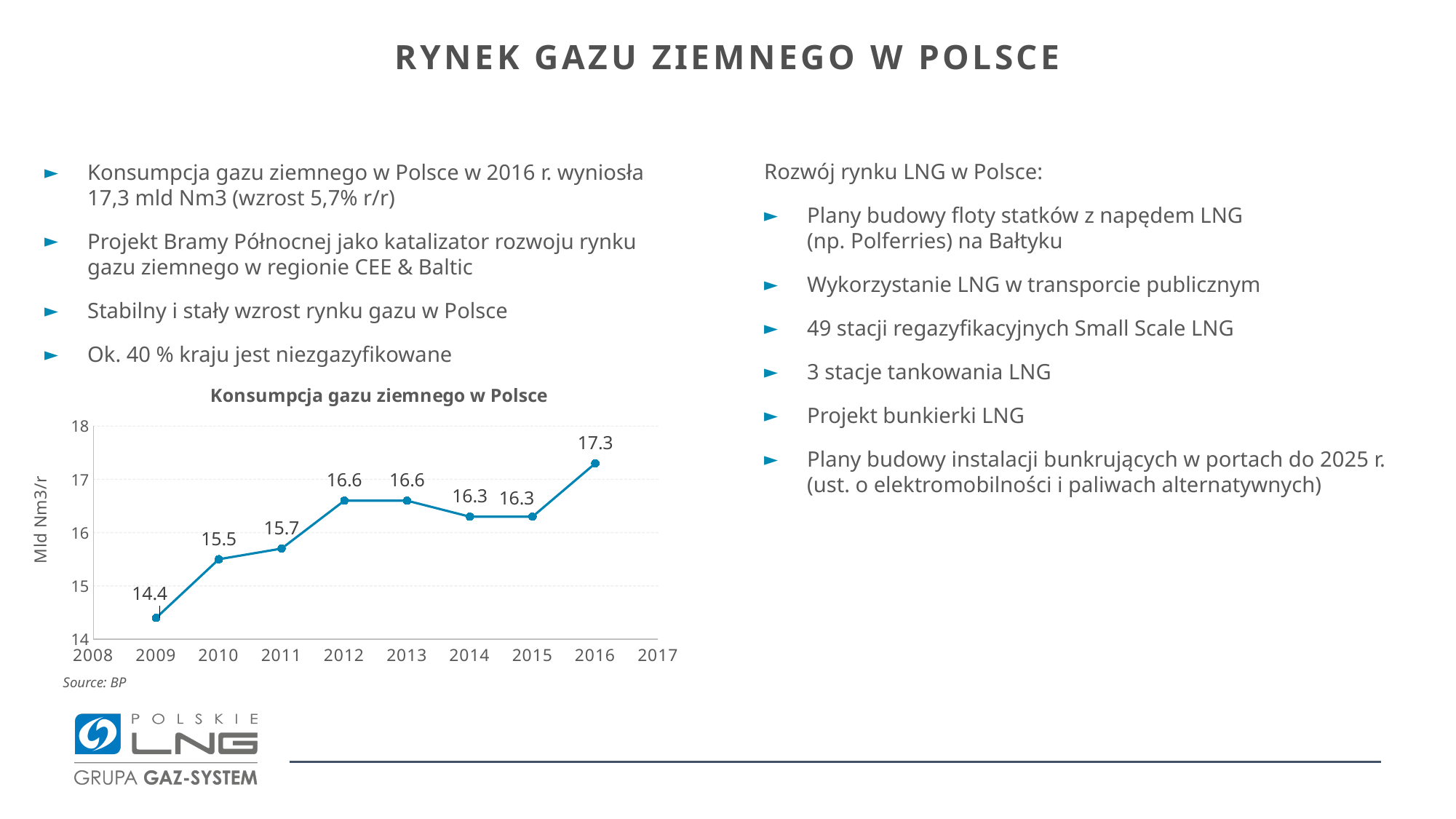
What type of chart is shown on the slide? line chart What was the gas consumption value in 2009? 14.4 Which year has the highest gas consumption value? 2016 What was the gas consumption value in 2012? 16.6 What is the overall trend of gas consumption from 2009 to 2016? rising What was the gas consumption value in 2016? 17.3 What is the difference between the 2016 value and the 2009 value? 2.9 Which year has the lowest gas consumption value? 2009 How many data points are plotted on the chart? 8 What is the label of the vertical axis? Mld Nm3/r What is the title of the chart? Konsumpcja gazu ziemnego w Polsce Which is larger, the value for 2011 or the value for 2014? 2014